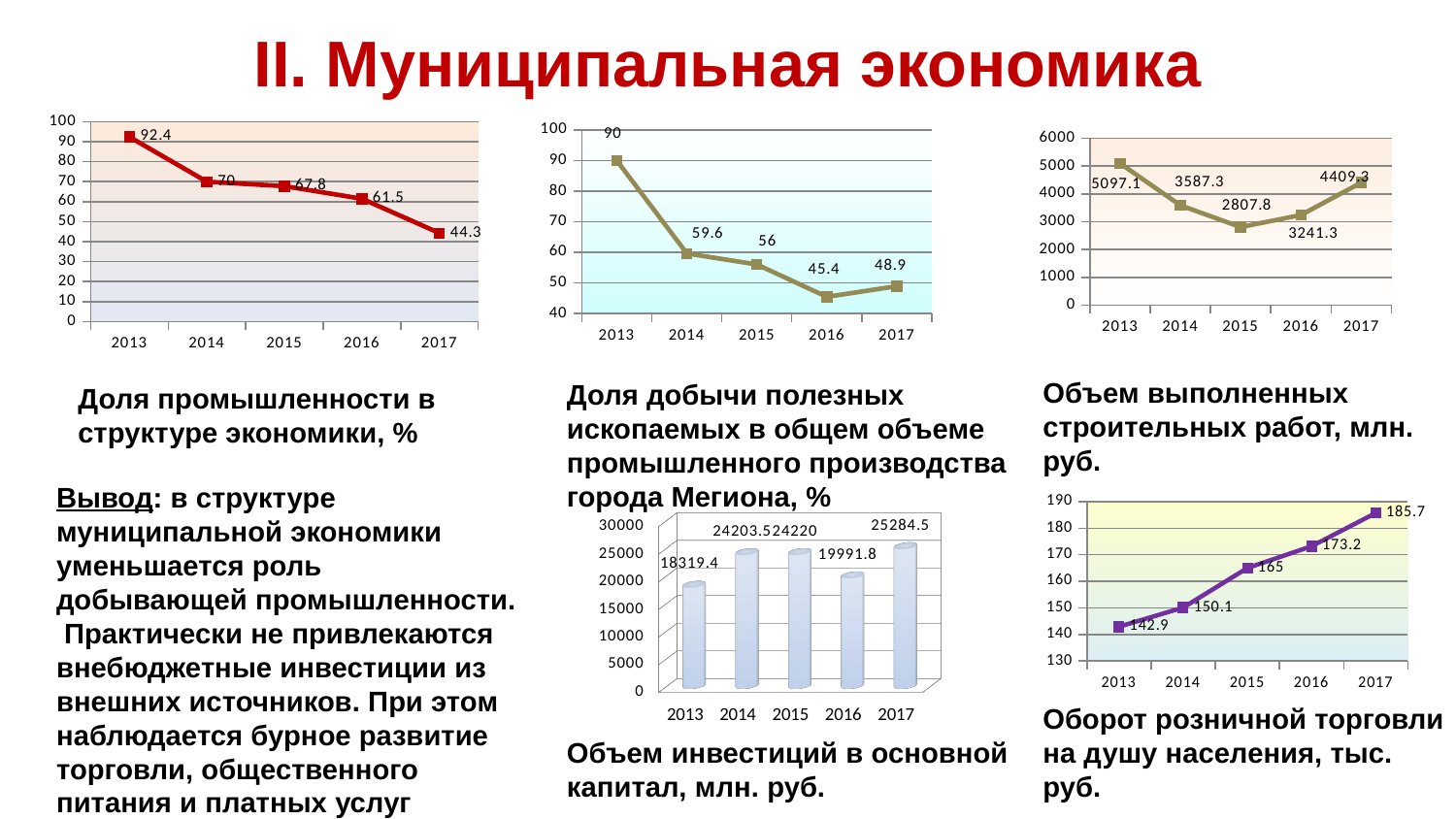
What kind of chart is 'Объем инвестиций в основной капитал, млн. руб.'? bar chart In the chart 'Объем выполненных строительных работ, млн. руб.', what is the value for 2016? 3241.3 In the chart 'Доля промышленности в структуре экономики, %', what is the value for 2013? 92.4 In the chart 'Объем инвестиций в основной капитал, млн. руб.', which year has the highest value? 2017 In the chart 'Объем инвестиций в основной капитал, млн. руб.', which is larger: the value for 2013 or the value for 2016? 2016 In the chart 'Доля добычи полезных ископаемых в общем объеме промышленного производства города Мегиона, %', which year has the lowest value? 2016 In the chart 'Оборот розничной торговли на душу населения, тыс. руб.', do the values rise or fall from 2013 to 2017? rise In the chart 'Объем выполненных строительных работ, млн. руб.', which year has the highest value? 2013 In the chart 'Доля добычи полезных ископаемых в общем объеме промышленного производства города Мегиона, %', what is the value for 2015? 56 In the chart 'Доля промышленности в структуре экономики, %', what is the difference between the 2013 and 2017 values? 48.1 How many years are plotted in the chart 'Оборот розничной торговли на душу населения, тыс. руб.'? 5 In the chart 'Оборот розничной торговли на душу населения, тыс. руб.', what is the value for 2015? 165